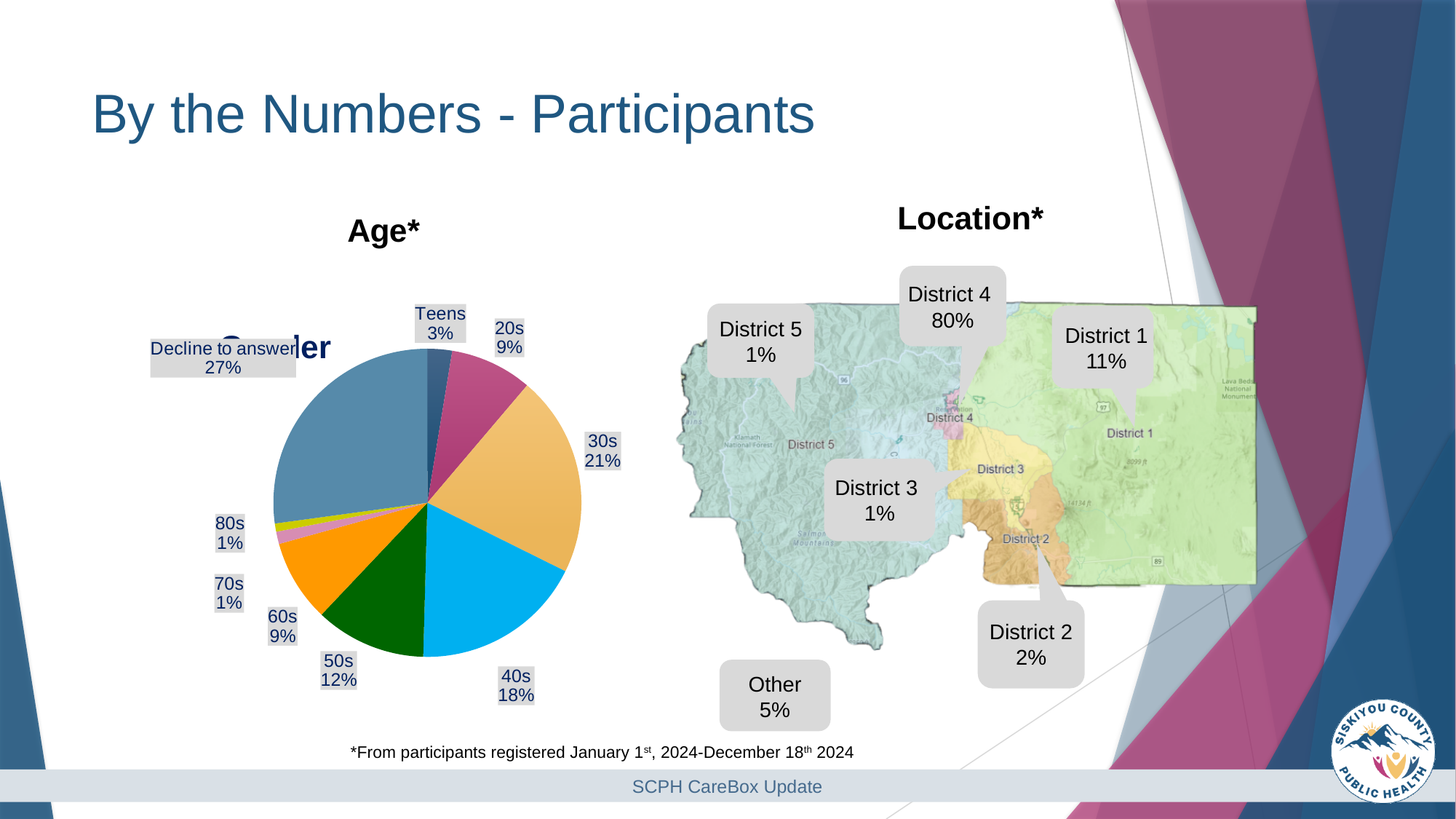
In the Age* pie chart, what percentage of participants are in their 30s? 21% On the Location* map, what percentage of participants are from District 4? 80% In the Age* pie chart, which is larger, the 50s slice or the 60s slice? 50s In the Age* pie chart, what percentage of participants are in their 50s? 12% In the Age* pie chart, how many categories are shown? 9 On the Location* map, what percentage of participants are from District 1? 11% In the Age* pie chart, which category has the largest slice? Decline to answer In the Age* pie chart, what share of participants declined to answer? 27% In the Age* pie chart, what is the difference between the 30s and 40s percentages? 3% In the Age* pie chart, what percentage of participants are in their 80s? 1% In the Age* pie chart, what percentage of participants are Teens? 3% What kind of chart is the Age* chart? pie chart